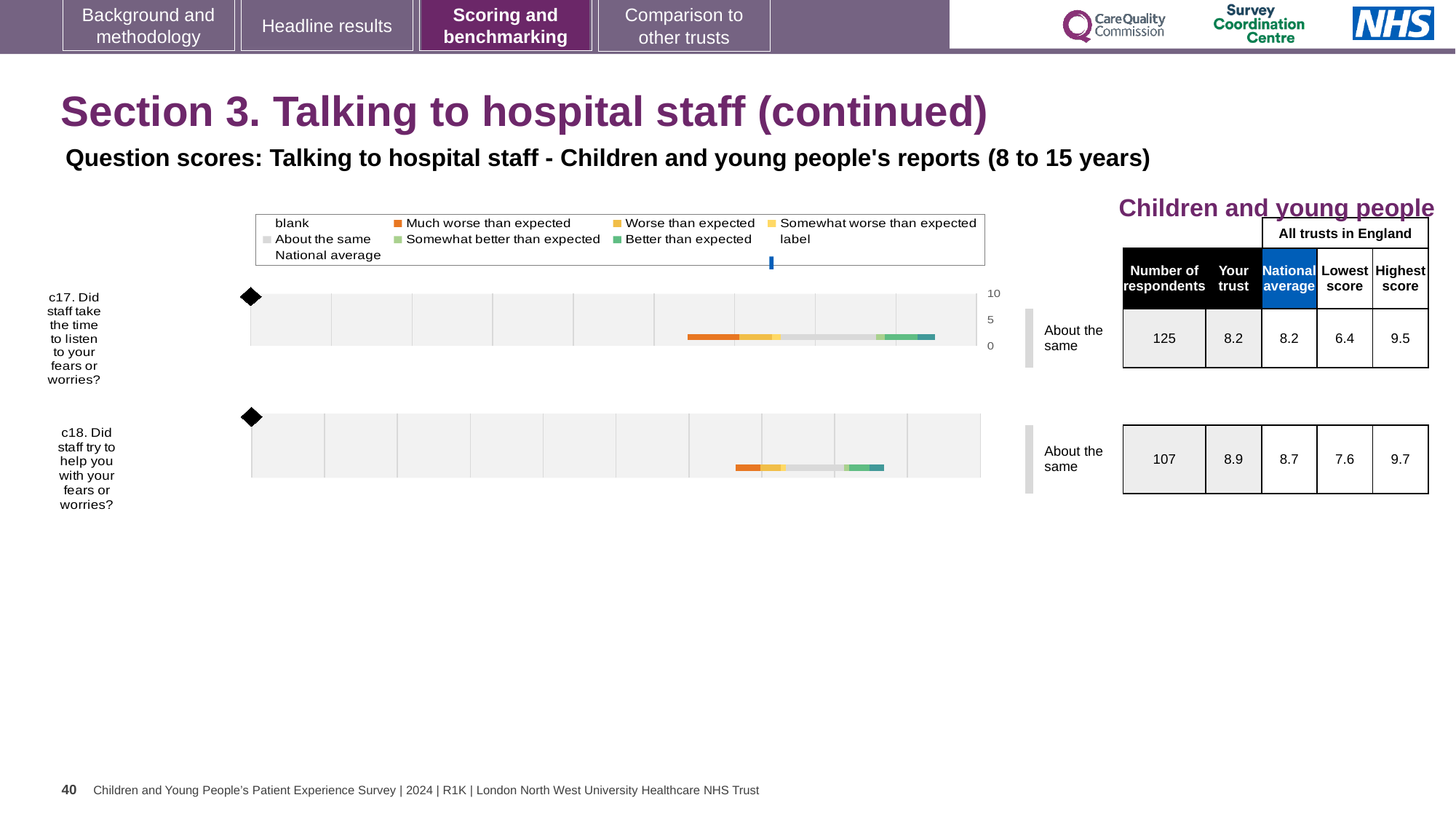
What is the number of respondents for c17 (Did staff take the time to listen to your fears or worries?)? 125 What is the difference between the highest and lowest scores for c18? 2.1 What benchmark category is shown for c17? About the same What kind of chart is used to show the question scores for c17 and c18? bar chart For c18, which is larger: the 'Your trust' score or the national average? Your trust What colour represents 'Much worse than expected' in the legend? orange How many survey questions are plotted on the slide? 2 What is the national average score for c17? 8.2 Which question has the higher number of respondents, c17 or c18? c17 What is the 'Your trust' score for c18 (Did staff try to help you with your fears or worries?)? 8.9 What is the lowest score among all trusts in England for c17? 6.4 What is the difference between the highest and lowest scores for c17? 3.1